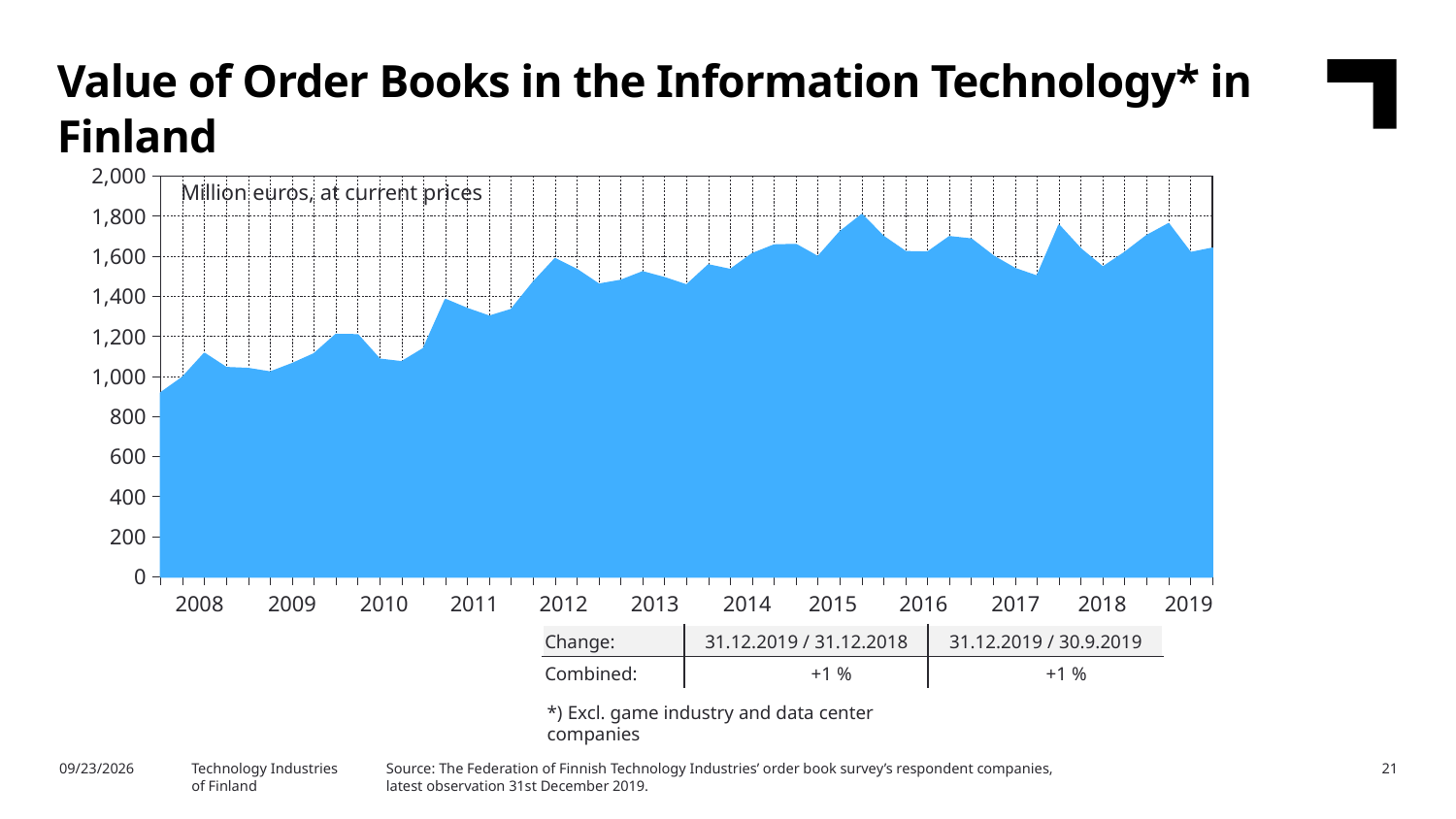
Is the value at the peak in 2015 greater or less than 1,600? greater Overall, do the values rise or fall from 2008 to 2019? rise Which year shows the lowest value in the chart? 2008 How many years are labelled on the x axis of the chart? 12 Is the value at the end of 2019 greater or less than 1,400? greater What kind of chart is shown on the slide? Area chart Is the value at the start of 2012 greater or less than 1,400? greater What unit is stated for the values in the chart? Million euros, at current prices What is the title of the chart on the slide? Value of Order Books in the Information Technology* in Finland Which is larger, the value at the start of 2008 or the value at the end of 2019? End of 2019